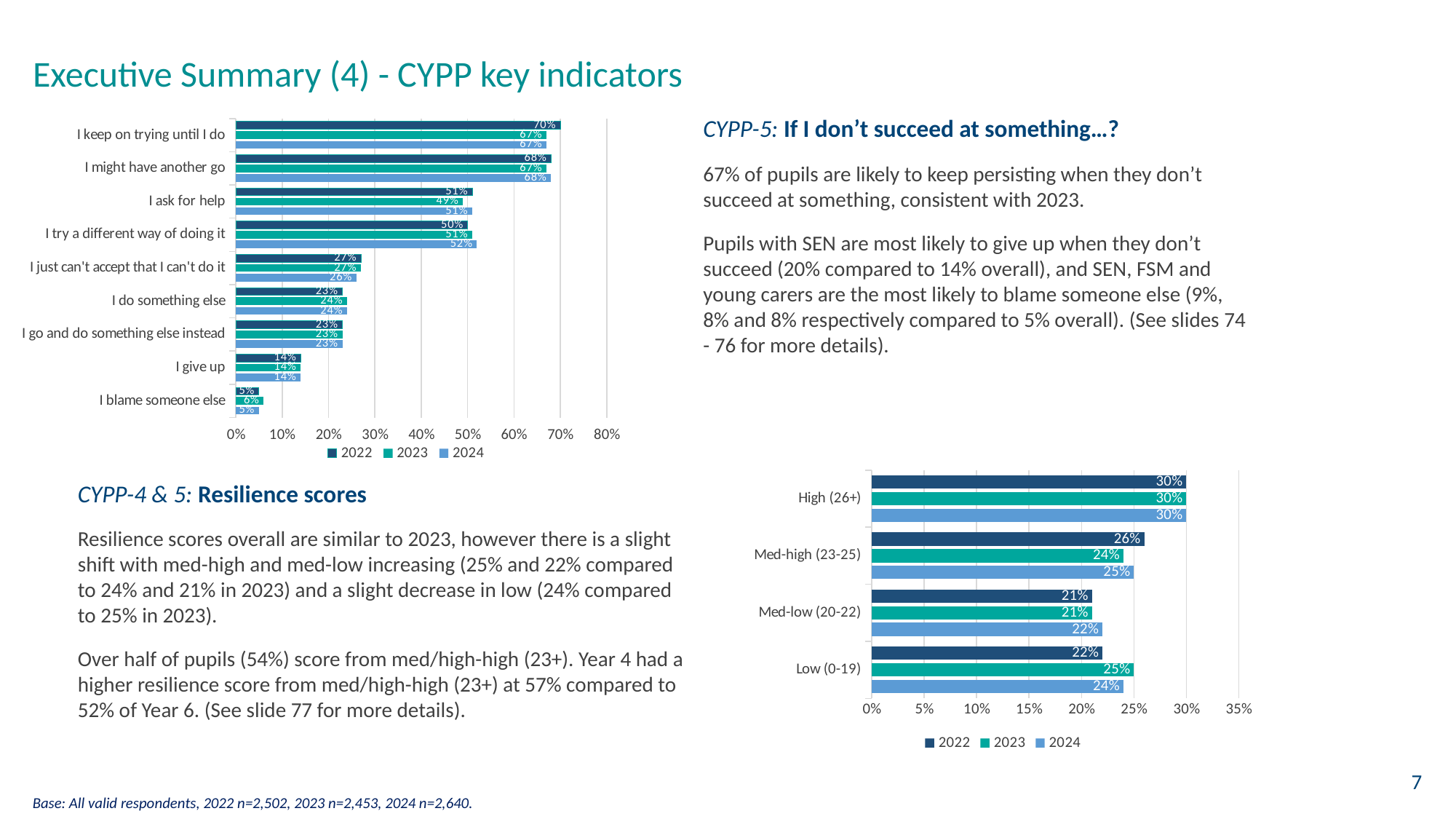
In the top-left chart, what is the 2024 value for 'I give up'? 14% In the bottom-right chart, is the 2022 value for 'Med-high (23-25)' larger or smaller than the 2023 value? Larger In the bottom-right chart, what is the maximum value shown on the horizontal axis? 35% In the bottom-right chart, what is the difference between the 2022 and 2024 values for 'Low (0-19)'? 2% In the bottom-right chart, what is the 2023 value for 'Low (0-19)'? 25% What type of chart is the top-left chart? Bar chart In the top-left chart, what is the 2022 value for 'I keep on trying until I do'? 70% In the top-left chart, what is the difference between the 2022 and 2023 values for 'I keep on trying until I do'? 3% In the top-left chart, how many series does the legend list? 3 In the top-left chart, how many categories are shown on the vertical axis? 9 In the top-left chart, which category has the lowest values across all years? I blame someone else In the bottom-right chart, which category has the highest values? High (26+)